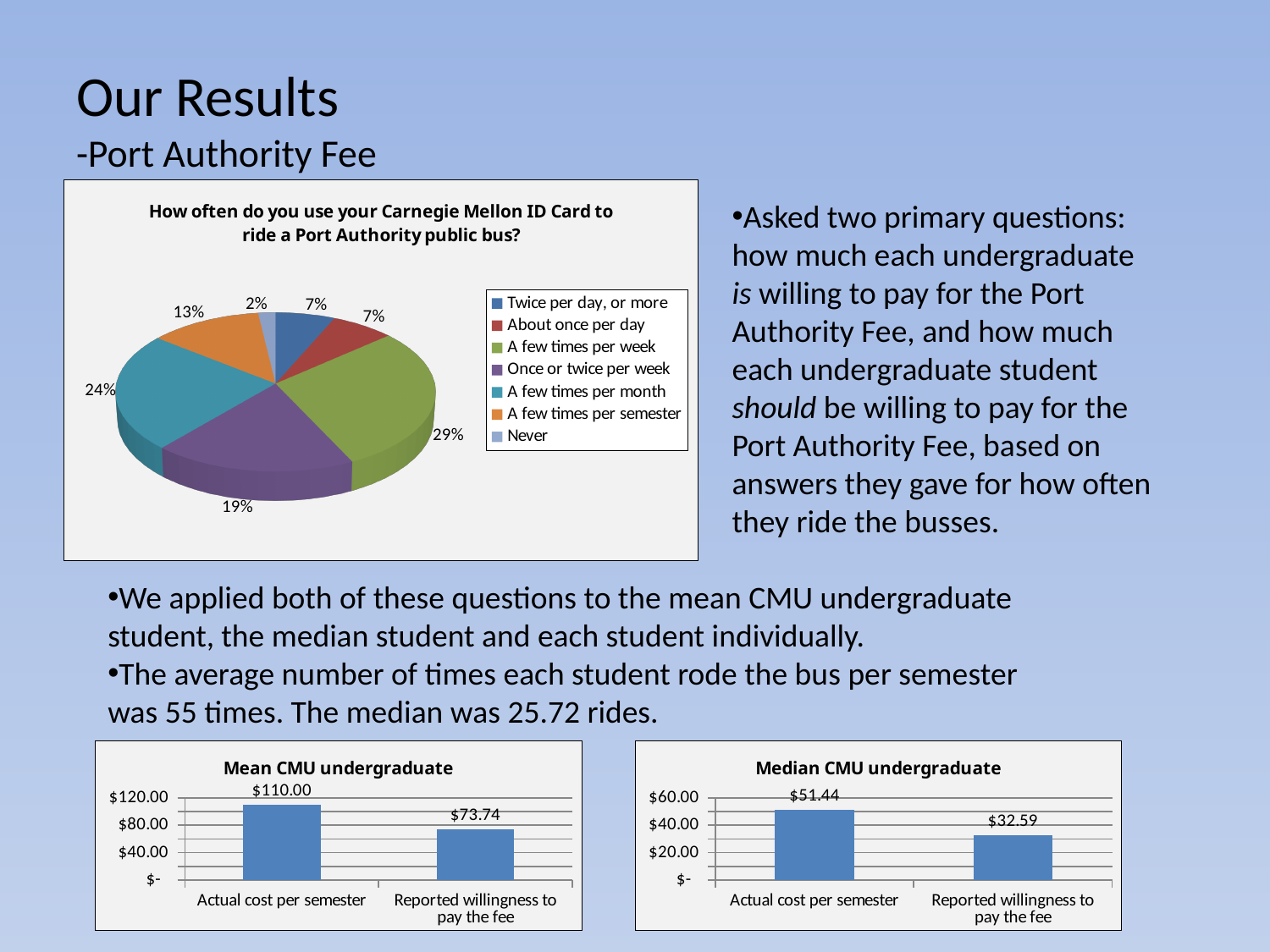
How many response categories does the legend of the pie chart 'How often do you use your Carnegie Mellon ID Card to ride a Port Authority public bus?' list? 7 In the 'Mean CMU undergraduate' chart, what is the difference between 'Actual cost per semester' and 'Reported willingness to pay the fee'? $36.26 In the 'Mean CMU undergraduate' chart, what is the value for 'Reported willingness to pay the fee'? $73.74 In the pie chart 'How often do you use your Carnegie Mellon ID Card to ride a Port Authority public bus?', which response has the largest share? A few times per week In the pie chart 'How often do you use your Carnegie Mellon ID Card to ride a Port Authority public bus?', which response has the smallest share? Never In the pie chart 'How often do you use your Carnegie Mellon ID Card to ride a Port Authority public bus?', what share of respondents answered 'Never'? 2% In the 'Median CMU undergraduate' chart, what is the value for 'Actual cost per semester'? $51.44 In the pie chart 'How often do you use your Carnegie Mellon ID Card to ride a Port Authority public bus?', what is the share for 'A few times per month'? 24% In the 'Mean CMU undergraduate' chart, what is the value for 'Actual cost per semester'? $110.00 In the pie chart 'How often do you use your Carnegie Mellon ID Card to ride a Port Authority public bus?', what share of respondents answered 'A few times per week'? 29% In the 'Median CMU undergraduate' chart, which is larger: 'Actual cost per semester' or 'Reported willingness to pay the fee'? Actual cost per semester What kind of chart is the 'Median CMU undergraduate' chart? Bar chart